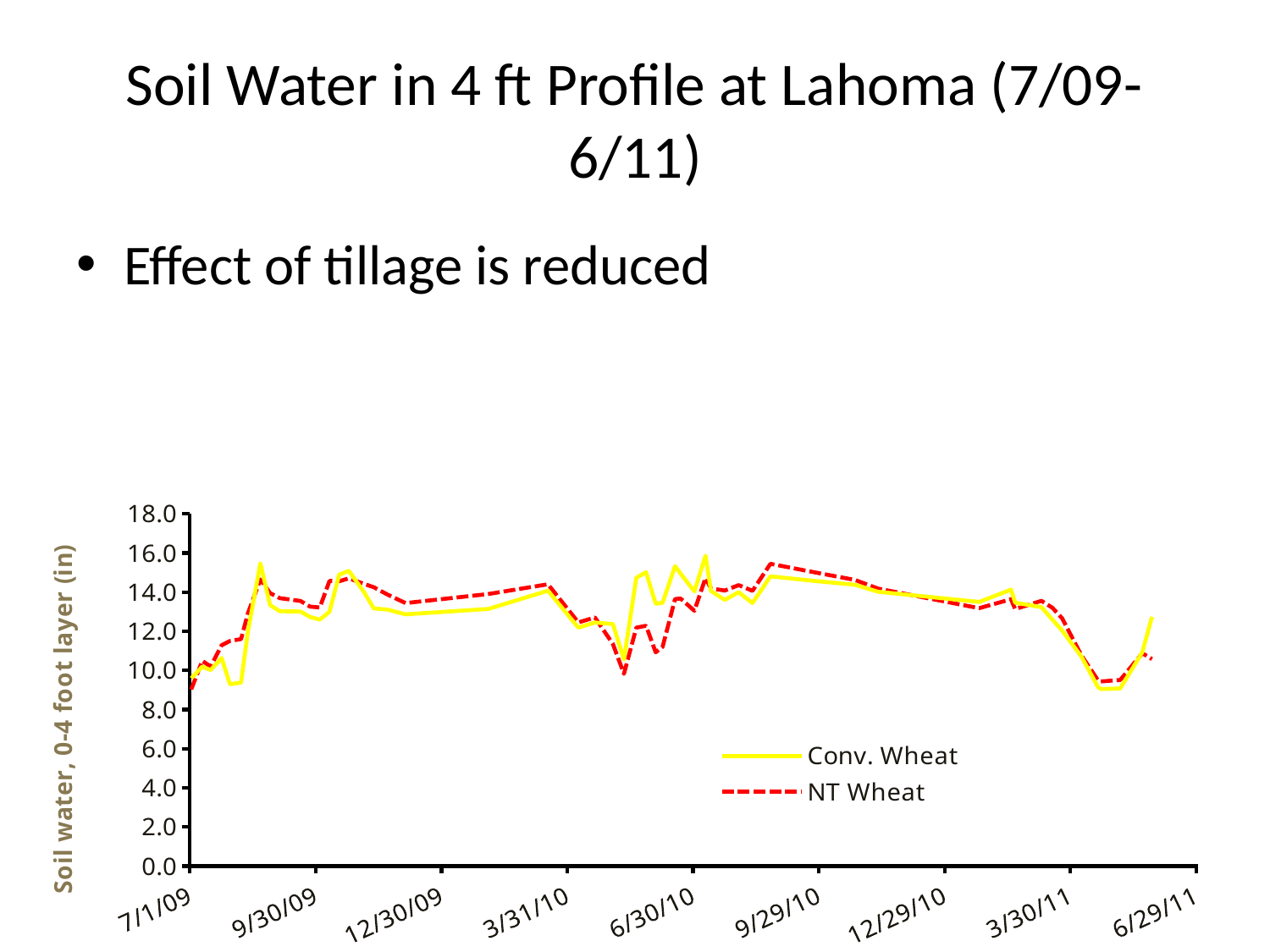
Is the lowest NT Wheat value between 3/31/10 and 6/30/10 greater or less than 12.0? less Is the NT Wheat value at 9/29/10 greater or less than 12.0? greater What is the title of the vertical axis? Soil water, 0-4 foot layer (in) Is the Conv. Wheat value at 12/30/09 greater or less than 10.0? greater Between 7/1/09 and 9/30/09, do the NT Wheat values generally rise or fall? rise How many date labels are shown along the x axis? 9 What are the two series named in the legend? Conv. Wheat and NT Wheat Between 9/29/10 and 3/30/11, do the Conv. Wheat values generally rise or fall? fall How many series does the legend list? 2 What kind of chart is shown on the slide? line chart